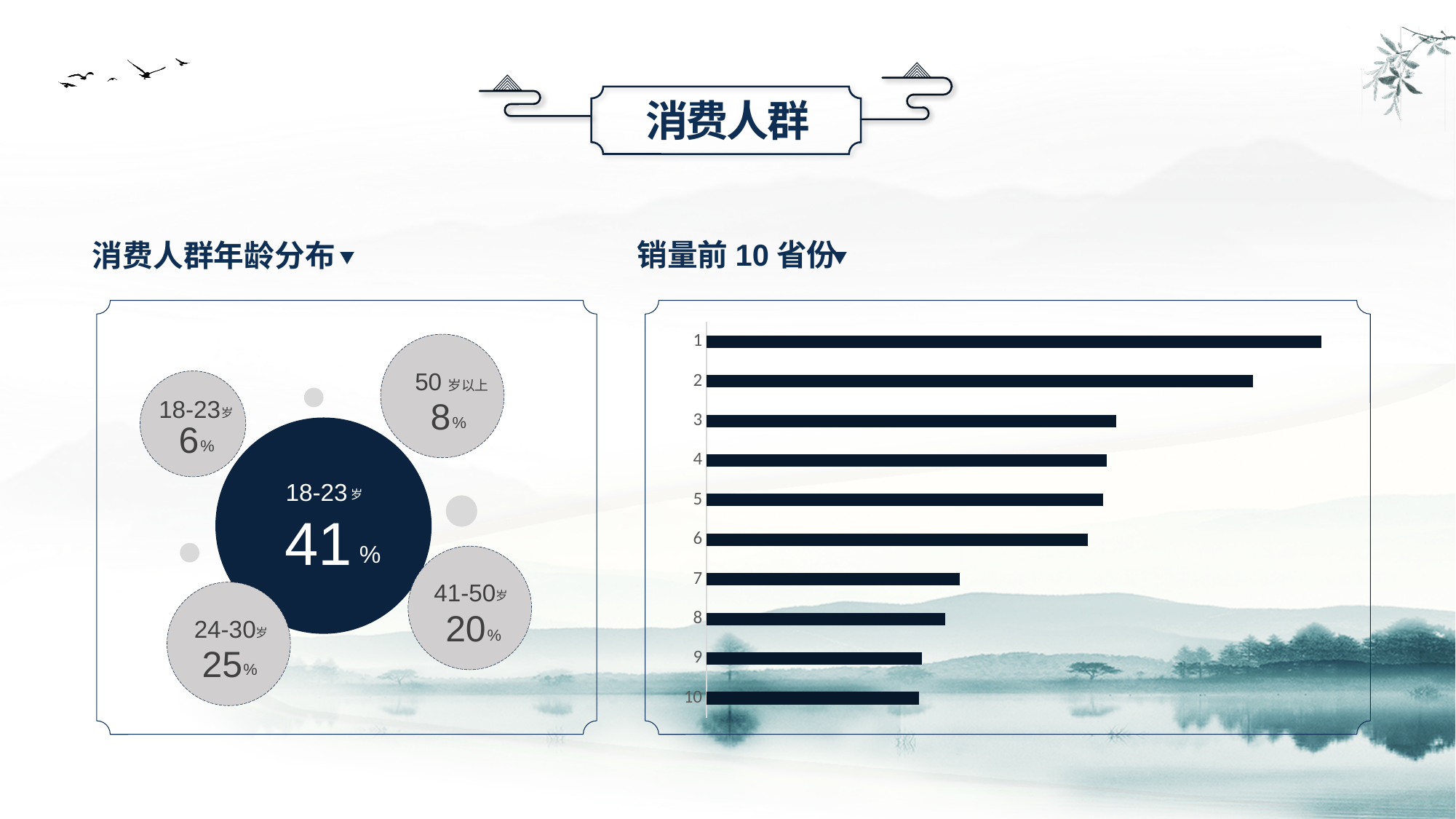
In the '消费人群年龄分布' chart on the left, what percentage is shown for the 50岁以上 group? 8% In the '销量前 10 省份' chart on the right, which category has the longest bar? 1 In the '销量前 10 省份' chart on the right, which bar is longer, 6 or 7? 6 In the '消费人群年龄分布' chart on the left, what percentage is shown for the 24-30岁 group? 25% In the '消费人群年龄分布' chart on the left, what is the difference in percentage points between the 24-30岁 group and the 41-50岁 group? 5 In the '销量前 10 省份' chart on the right, is the bar for 2 longer or shorter than the bar for 3? longer How many bars are shown in the '销量前 10 省份' chart on the right? 10 In the '消费人群年龄分布' chart on the left, what percentage is shown for the 41-50岁 group? 20% In the '销量前 10 省份' chart on the right, do the bar lengths generally increase or decrease from category 1 to category 10? decrease In the '消费人群年龄分布' chart on the left, what percentage is shown in the large dark central circle? 41% In the '消费人群年龄分布' chart on the left, which group has the larger share, 41-50岁 or 50岁以上? 41-50岁 What type of chart is the '销量前 10 省份' chart on the right? bar chart